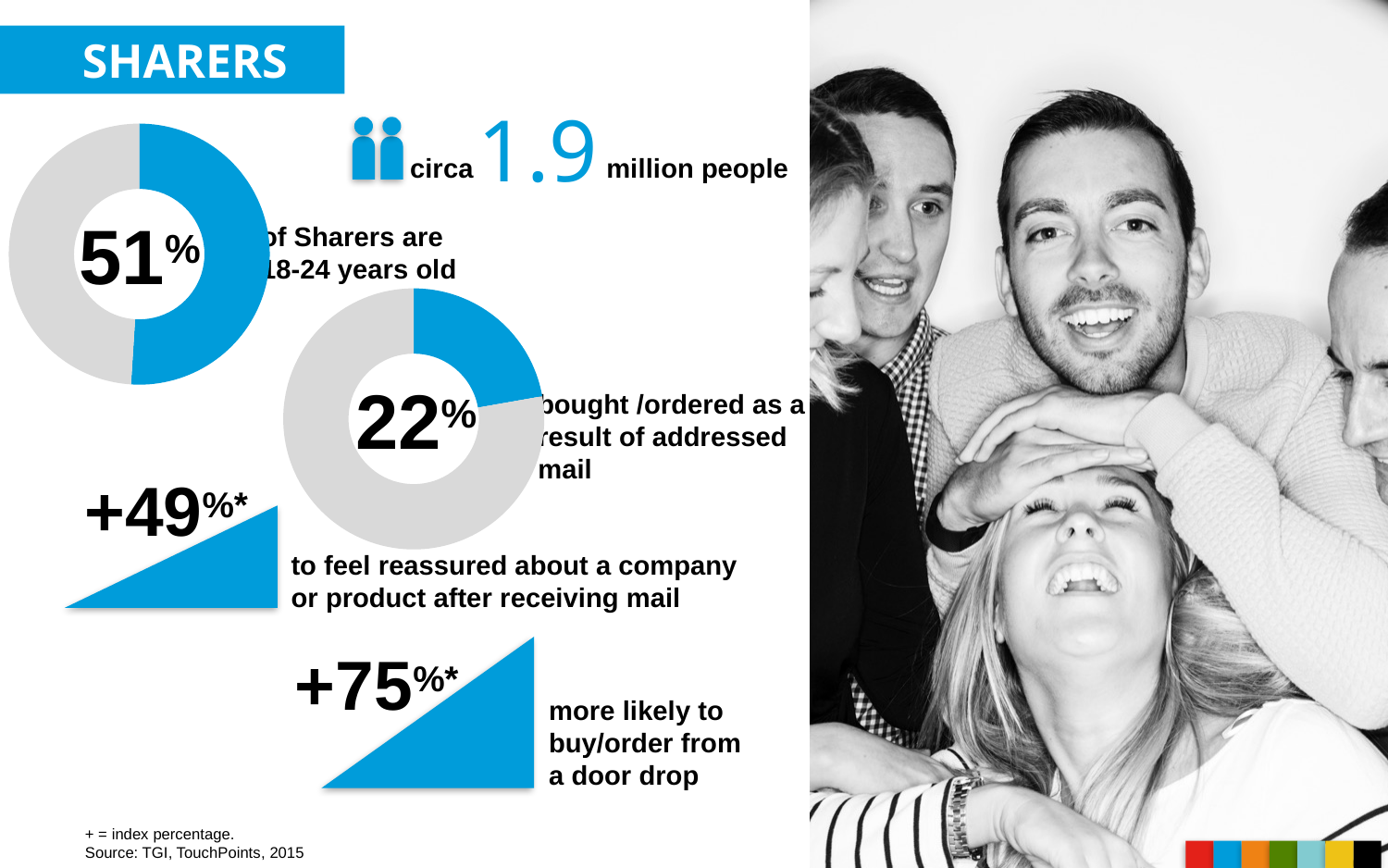
Which donut chart shows the larger highlighted value, the upper-left one or the lower one? The upper-left one (51%) What value is shown in the lower donut chart? 22% What kind of chart is the upper-left chart showing 51%? Donut (pie) chart How many donut charts are on the slide? 2 What does the 22% donut chart represent? Bought/ordered as a result of addressed mail In the lower donut chart, is the blue slice larger or smaller than the grey slice? Smaller What value is shown in the upper-left donut chart? 51% According to the upper-left donut chart, what percentage of Sharers are 18-24 years old? 51% According to the lower donut chart, what percentage bought/ordered as a result of addressed mail? 22% What is the difference between the values shown in the two donut charts (51% and 22%)? 29 percentage points What colour is used for the highlighted slice in both donut charts? Blue